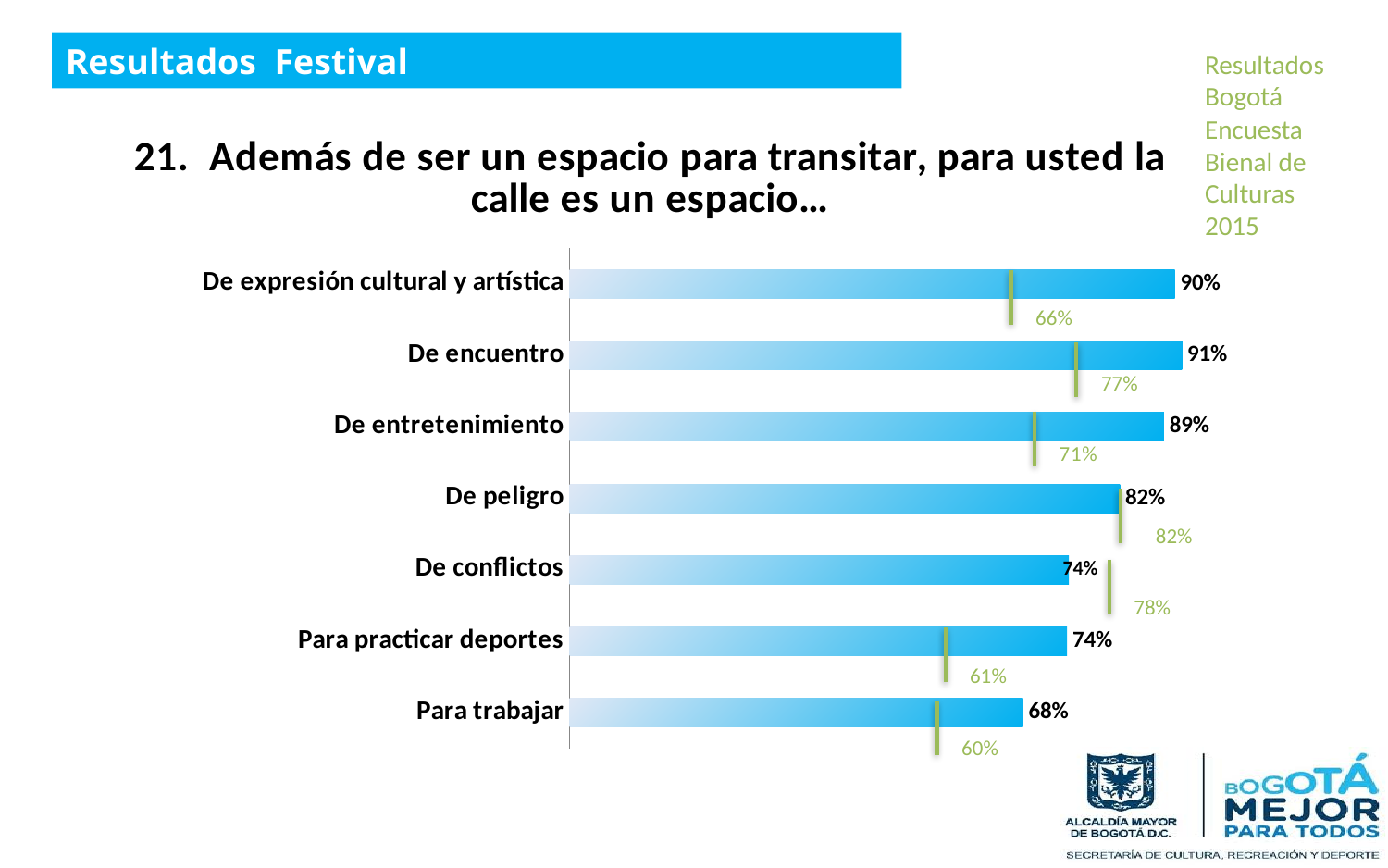
Which category has the same Festival value and Bogotá 2015 value? De peligro What is the Festival value for "Para trabajar"? 68% What is the difference between the Festival value and the Bogotá 2015 value for "De expresión cultural y artística"? 24% Which category has the highest Festival value (blue bar)? De encuentro What is the difference between the Festival values for "De encuentro" and "Para trabajar"? 23% Which is larger for "De conflictos": the Festival value or the Bogotá 2015 value? Bogotá 2015 value How many categories are shown in the chart? 7 What type of chart is shown on the slide? Bar chart What is the green Bogotá Encuesta Bienal de Culturas 2015 value for "De expresión cultural y artística"? 66% What is the Festival value for "De encuentro"? 91% What is the green Bogotá Encuesta Bienal de Culturas 2015 value for "De conflictos"? 78% Which category has the lowest Festival value (blue bar)? Para trabajar